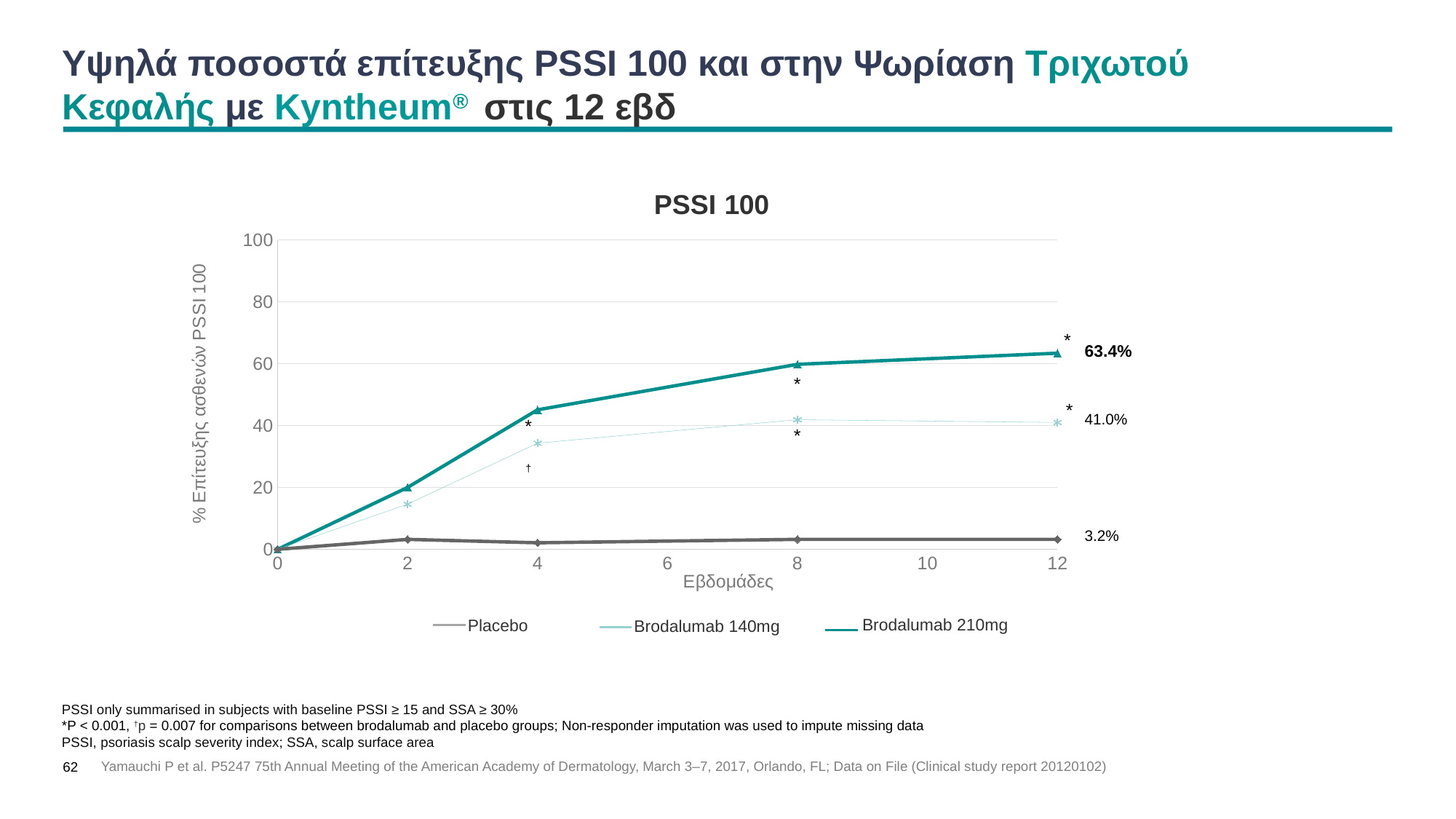
How many series does the legend list? 3 What kind of chart is shown? Line chart What is the difference between the Brodalumab 210mg and Brodalumab 140mg values at week 12? 22.4% Does the Brodalumab 210mg line rise or fall from week 0 to week 12? Rise Which series has the lowest value at week 12? Placebo What is the value for Brodalumab 210mg at week 12? 63.4% At week 12, which is larger: Brodalumab 140mg or Placebo? Brodalumab 140mg What is the value for Placebo at week 12? 3.2% Which series has the highest value at week 12? Brodalumab 210mg Is the value for Brodalumab 210mg at week 8 greater or less than 40? greater What is the value for Brodalumab 140mg at week 12? 41.0% Is the value for Brodalumab 140mg at week 4 greater or less than 40? less